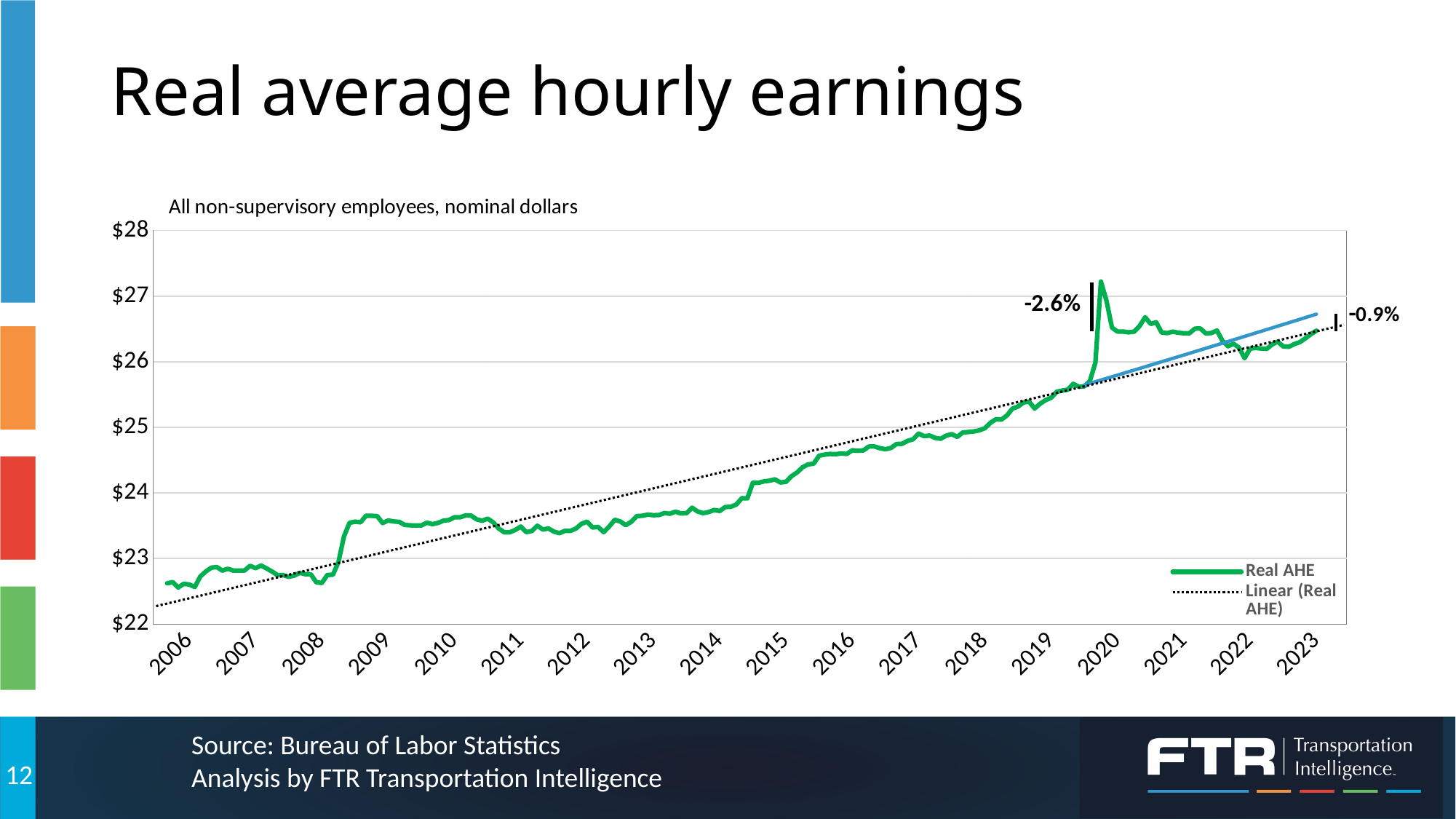
In which year does the Real AHE line reach its highest point? 2020 Which is larger, the Real AHE value at the start of 2016 or at the start of 2010? 2016 Is the Real AHE value at the start of 2006 greater or less than $23? less What percentage is annotated next to the spike in 2020? -2.6% Is the Real AHE value at the start of 2012 greater or less than $24? less What is the subtitle printed above the chart? All non-supervisory employees, nominal dollars How many series does the legend list? 2 Is the Real AHE value at the start of 2019 greater or less than $25? greater Do the Real AHE values generally rise or fall from 2006 to 2023? rise How many year labels are shown along the x axis? 18 What kind of chart is shown on the slide? line chart